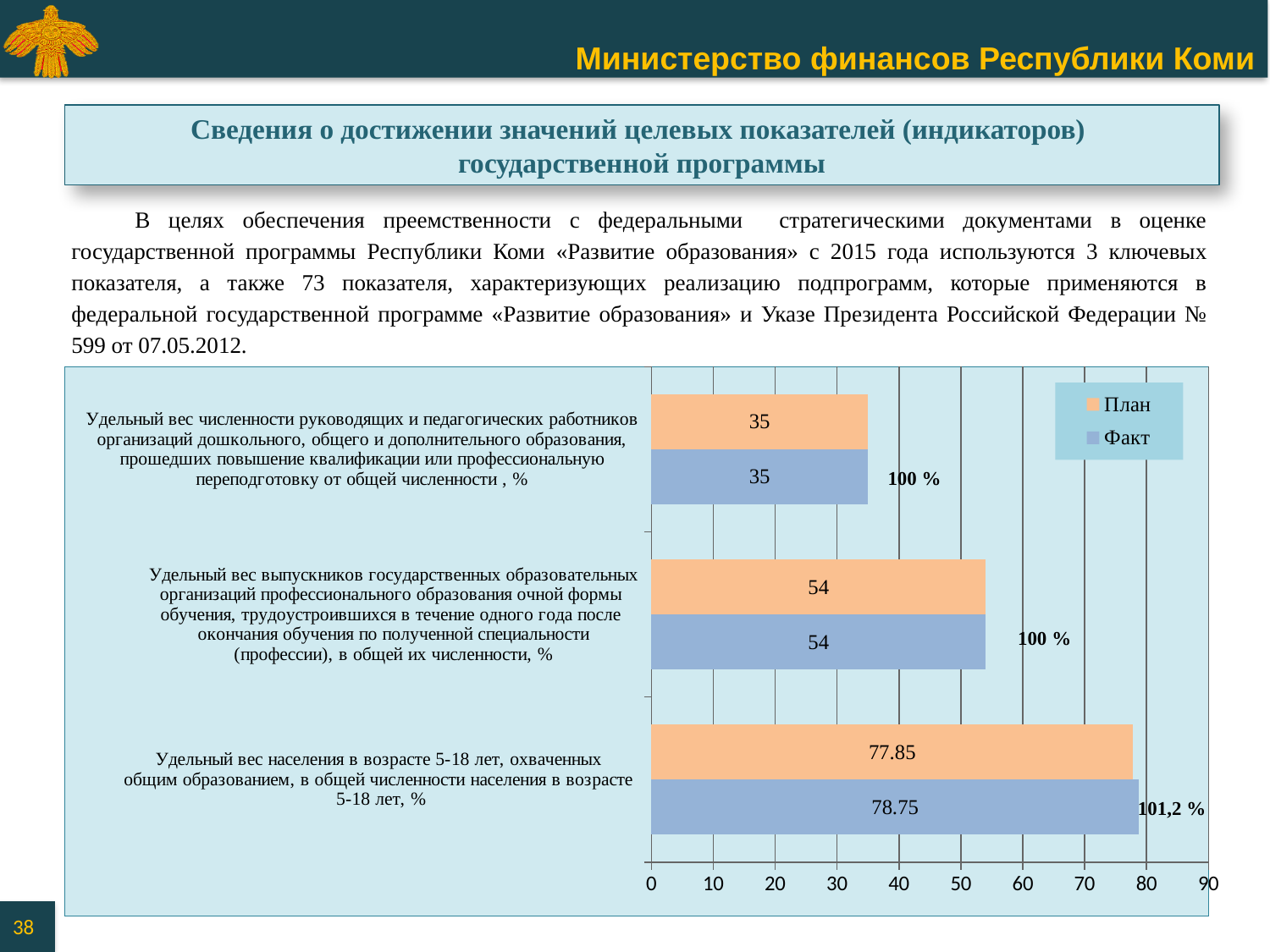
How many categories are plotted in the chart? 3 What is the Факт value for the category about graduates of professional education organisations employed within one year after graduation? 54 What is the План value for the category about managerial and teaching staff who completed advanced training or retraining? 35 What is the difference between the Факт and План values for the category about the population aged 5-18 covered by general education? 0.9 What percentage of plan achievement is annotated next to the bars for the category about the population aged 5-18 covered by general education? 101,2 % Which category has the highest Факт value? Удельный вес населения в возрасте 5-18 лет, охваченных общим образованием, в общей численности населения в возрасте 5-18 лет, % What is the План value for the category about the share of the population aged 5-18 covered by general education? 77.85 What are the two series named in the chart legend? План and Факт How many series does the chart legend list? 2 What type of chart is shown on the slide? bar chart What is the Факт value for the category about the share of the population aged 5-18 covered by general education? 78.75